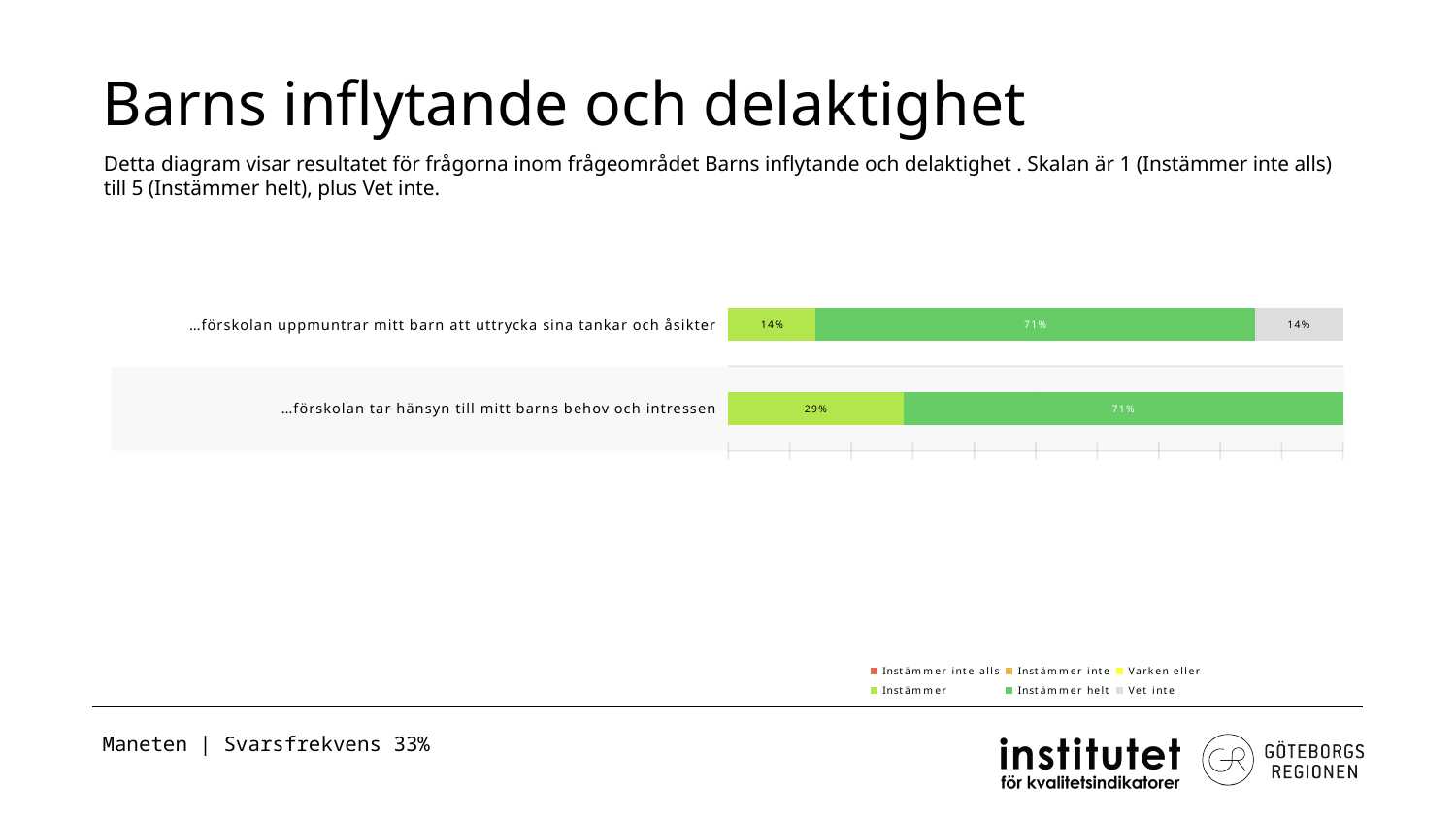
How many categories (questions) are plotted in the chart? 2 What is the difference between the 'Instämmer' values for the two questions? 15% What is the value of 'Instämmer' for '…förskolan uppmuntrar mitt barn att uttrycka sina tankar och åsikter'? 14% What is the value of 'Instämmer helt' for '…förskolan uppmuntrar mitt barn att uttrycka sina tankar och åsikter'? 71% What is the last entry in the chart legend? Vet inte What kind of chart is shown on the slide? stacked bar chart What is the value of 'Vet inte' for '…förskolan uppmuntrar mitt barn att uttrycka sina tankar och åsikter'? 14% Which segment is the largest in the bar for '…förskolan uppmuntrar mitt barn att uttrycka sina tankar och åsikter'? Instämmer helt What is the value of 'Instämmer' for '…förskolan tar hänsyn till mitt barns behov och intressen'? 29% How many series does the legend list? 6 What is the total of the labelled segments for '…förskolan tar hänsyn till mitt barns behov och intressen'? 100% Which question has the larger 'Instämmer' share? …förskolan tar hänsyn till mitt barns behov och intressen